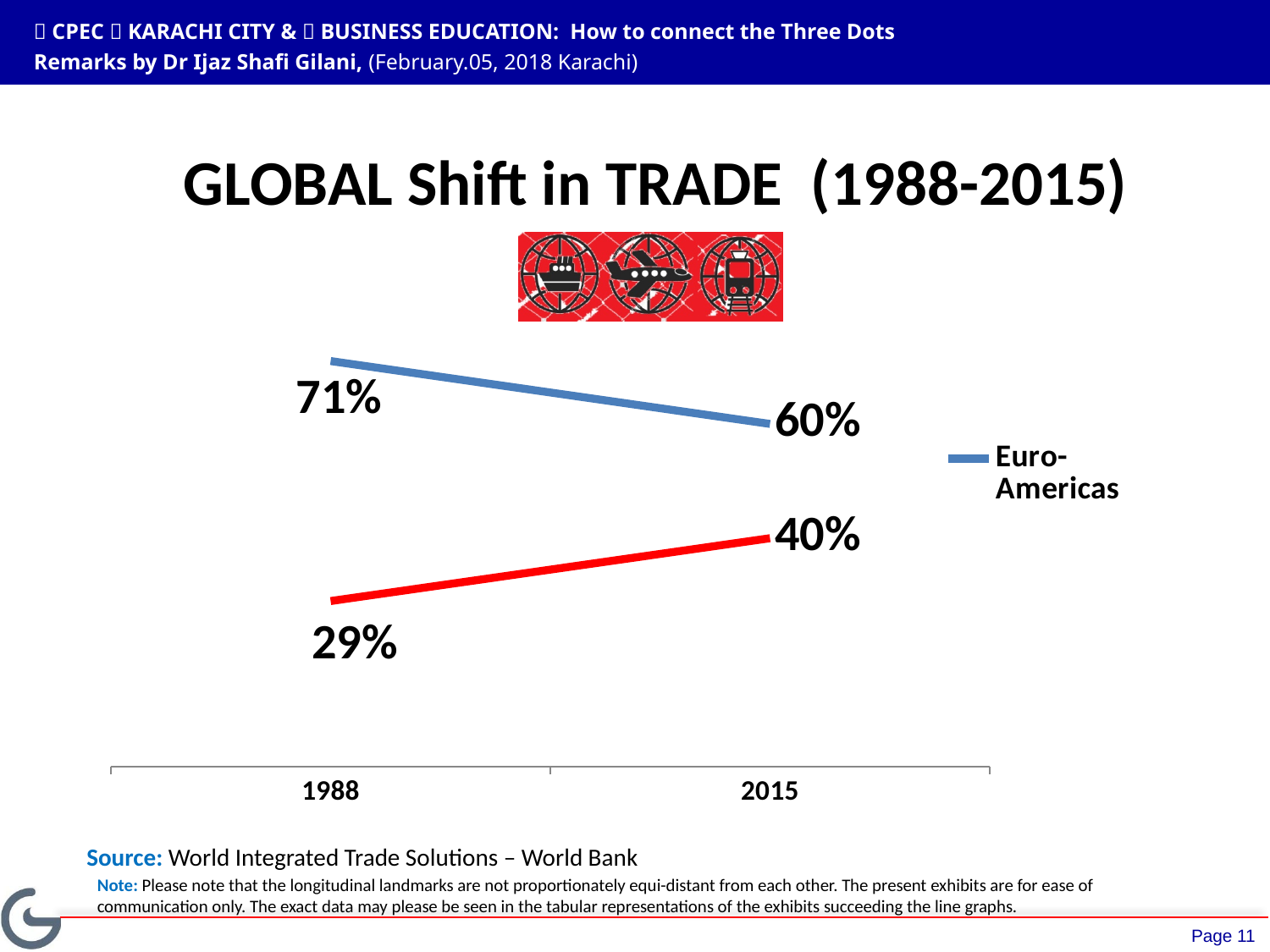
How many years are shown on the x axis? 2 Does the red line rise or fall from 1988 to 2015? rise By how many percentage points did the Euro-Americas value fall from 1988 to 2015? 11 In 2015, which is larger: the Euro-Americas value or the red line's value? Euro-Americas What value does the red line show in 1988? 29% What is the value for Euro-Americas in 1988? 71% What is the title of the chart? GLOBAL Shift in TRADE (1988-2015) What is the value for Euro-Americas in 2015? 60% What kind of chart is shown on the slide? line chart Does the Euro-Americas line rise or fall from 1988 to 2015? fall What value does the red line show in 2015? 40% By how many percentage points did the red line rise from 1988 to 2015? 11